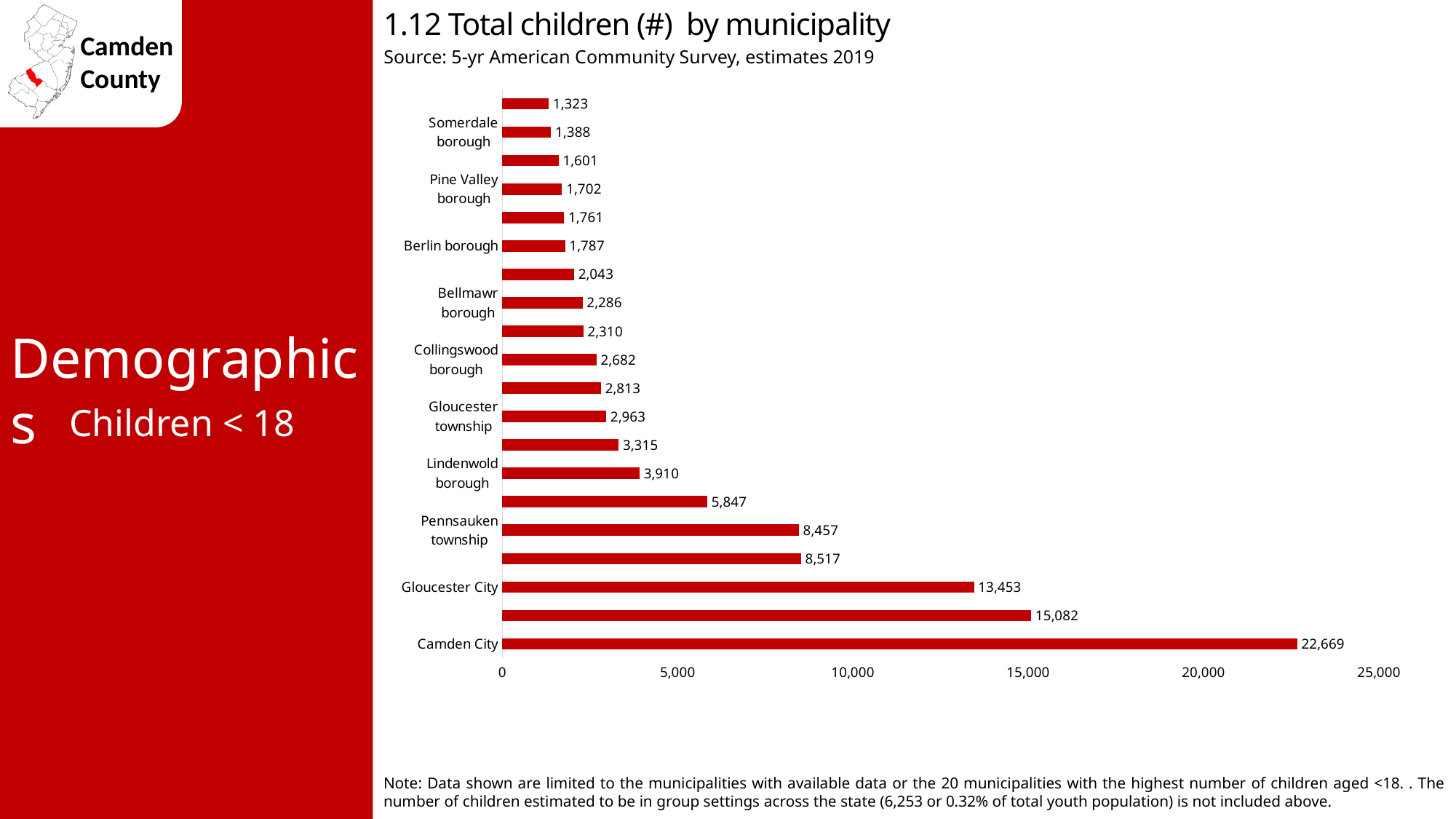
Which has a larger value, Gloucester City or Pennsauken township? Gloucester City What is the total number of children shown for Camden City? 22,669 What is the total number of children shown for Pennsauken township? 8,457 How many bars are plotted in the chart? 20 Which municipality has the highest number of children in the chart? Camden City What is the smallest value labelled on any bar in the chart? 1,323 What kind of chart is shown on the slide? Bar chart What is the title of the chart? 1.12 Total children (#) by municipality What is the total number of children shown for Lindenwold borough? 3,910 What is the difference between the values for Camden City and Gloucester City? 9,216 Is the value for Camden City greater or less than 20,000? greater What is the total number of children shown for Gloucester City? 13,453